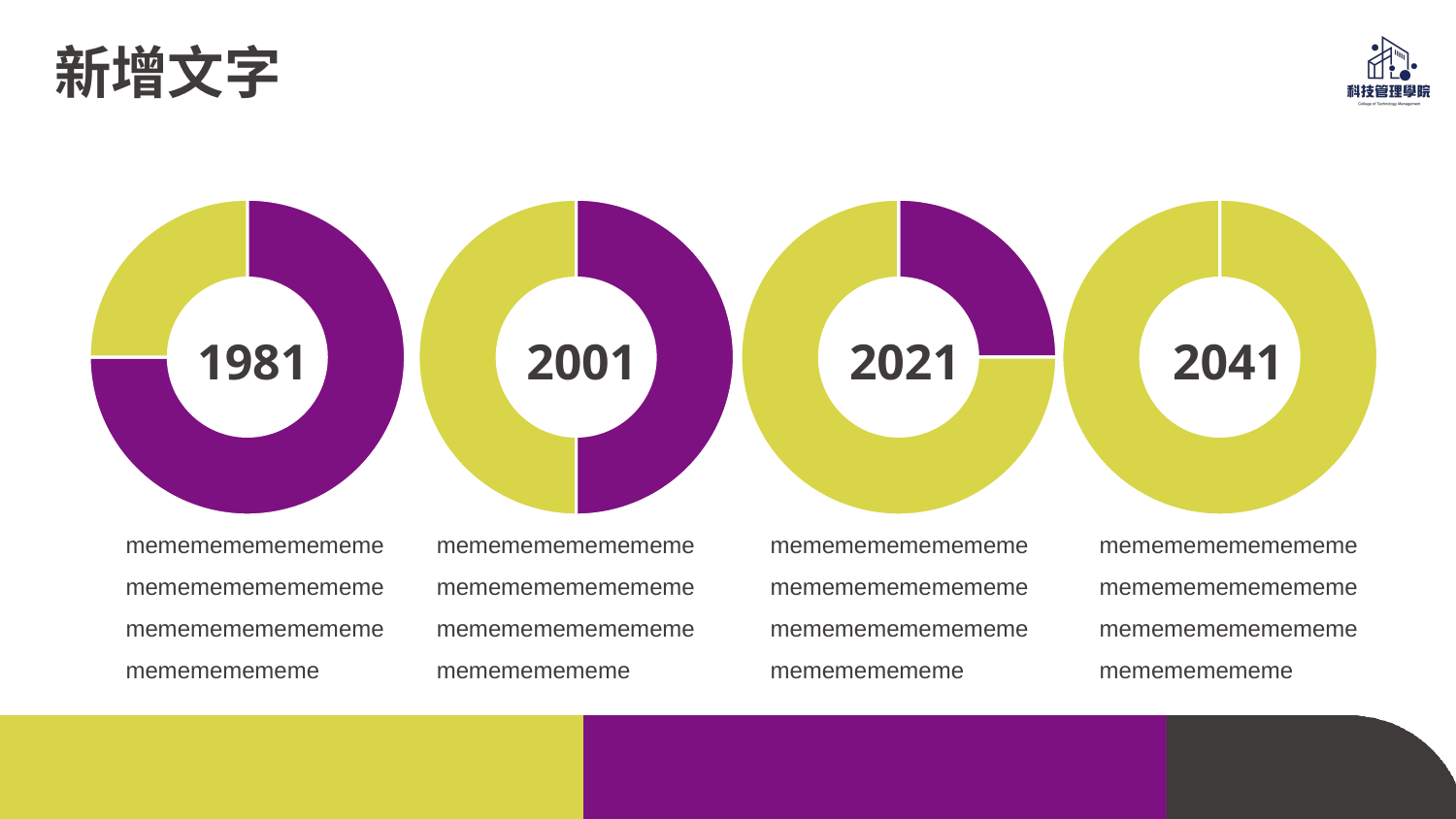
Which of the four donut charts has the smallest purple slice? 2041 What kind of chart is used for each of the four years on the slide? Donut (pie) chart What year label is shown in the centre of the second donut chart from the left? 2001 Which of the four donut charts has the largest yellow-green slice? 2041 In the 1981 donut chart, which slice is larger, the purple one or the yellow-green one? Purple In the 2021 donut chart, which slice is larger, the purple one or the yellow-green one? Yellow-green In the 2041 donut chart, which slice is larger, the purple one or the yellow-green one? Yellow-green How many donut charts are shown on the slide? 4 Moving from the 1981 chart to the 2041 chart, does the purple share rise or fall? Fall Which of the four donut charts has the largest purple slice? 1981 What two colours are used for the slices in the donut charts? Purple and yellow-green